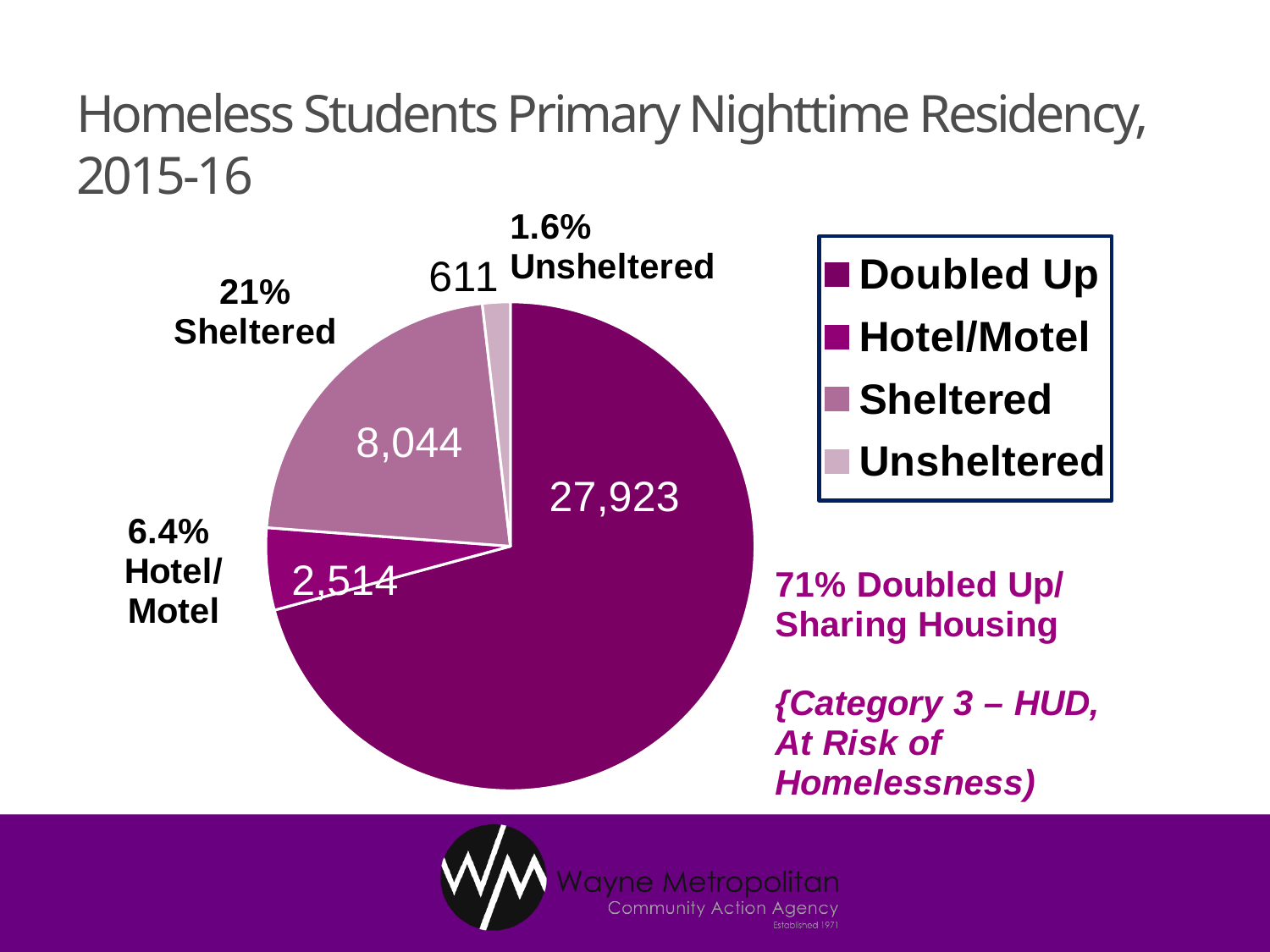
Which is larger, the Sheltered value or the Unsheltered value? Sheltered How many students are in the Hotel/Motel category? 2,514 What is the difference between the Sheltered and Hotel/Motel values? 5,530 How many categories does the legend list? 4 Which category has the smallest slice of the pie? Unsheltered How many students are in the Sheltered category? 8,044 What share of the pie does the Sheltered slice represent? 21% Which category has the largest slice of the pie? Doubled Up How many students are in the Unsheltered category? 611 What share of the pie does the Hotel/Motel slice represent? 6.4% How many students are in the Doubled Up category? 27,923 What kind of chart is shown on the slide? pie chart